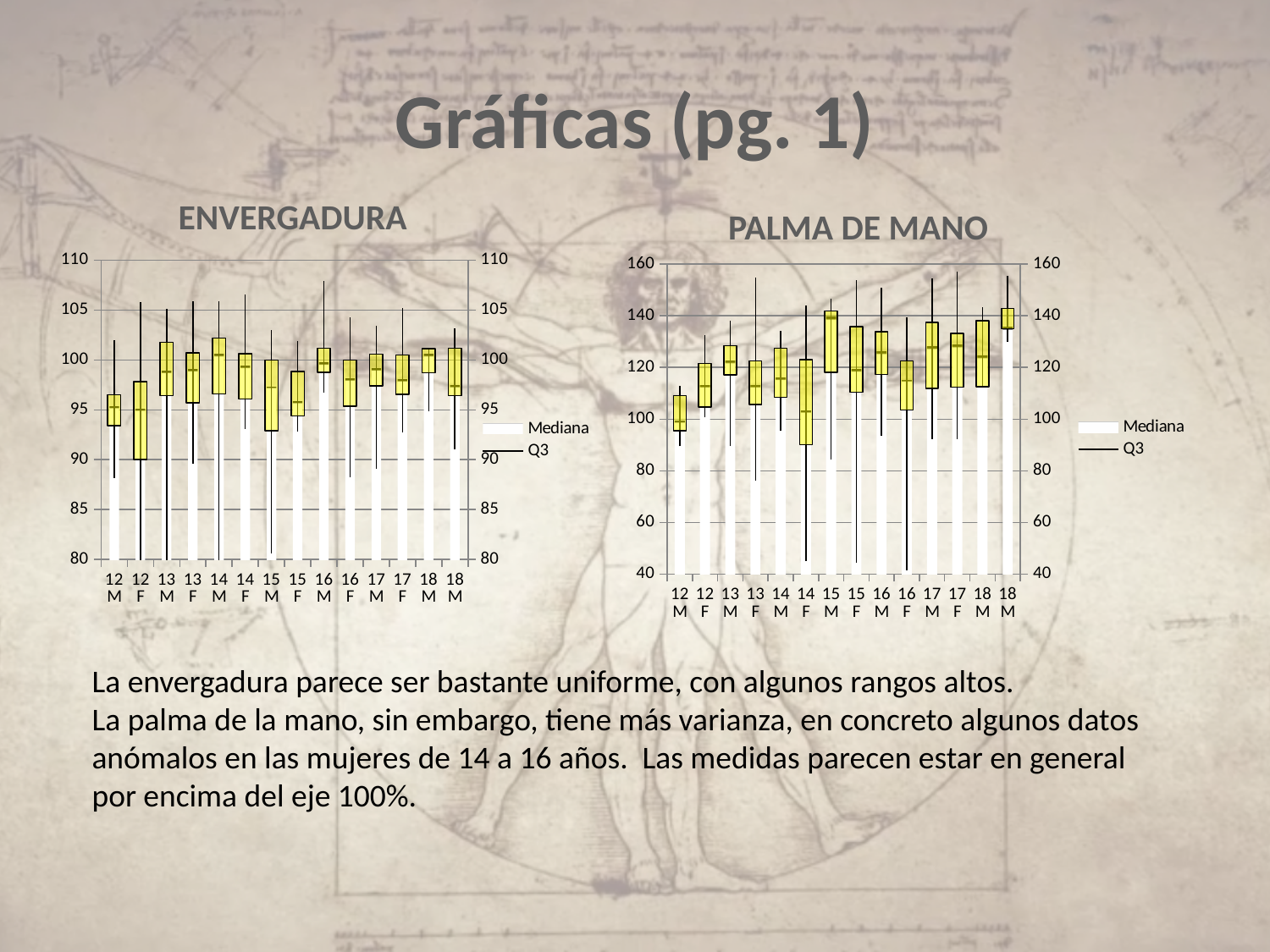
In the ENVERGADURA chart, how many series does the legend list? 2 In the PALMA DE MANO chart, which has the larger median (Mediana): 12 M or 15 M? 15 M In the PALMA DE MANO chart, is the median (Mediana) for 14 F greater or less than 120? less In the PALMA DE MANO chart, is the median (Mediana) for 12 M greater or less than 120? less What is the title of the chart on the left? ENVERGADURA What is the title of the chart on the right? PALMA DE MANO In the ENVERGADURA chart, is the median (Mediana) for 12 F greater or less than 90? greater In the ENVERGADURA chart, which has the larger median (Mediana): 12 F or 14 M? 14 M In the PALMA DE MANO chart, how many categories are shown on the x axis? 14 In the ENVERGADURA chart, how many categories are shown on the x axis? 14